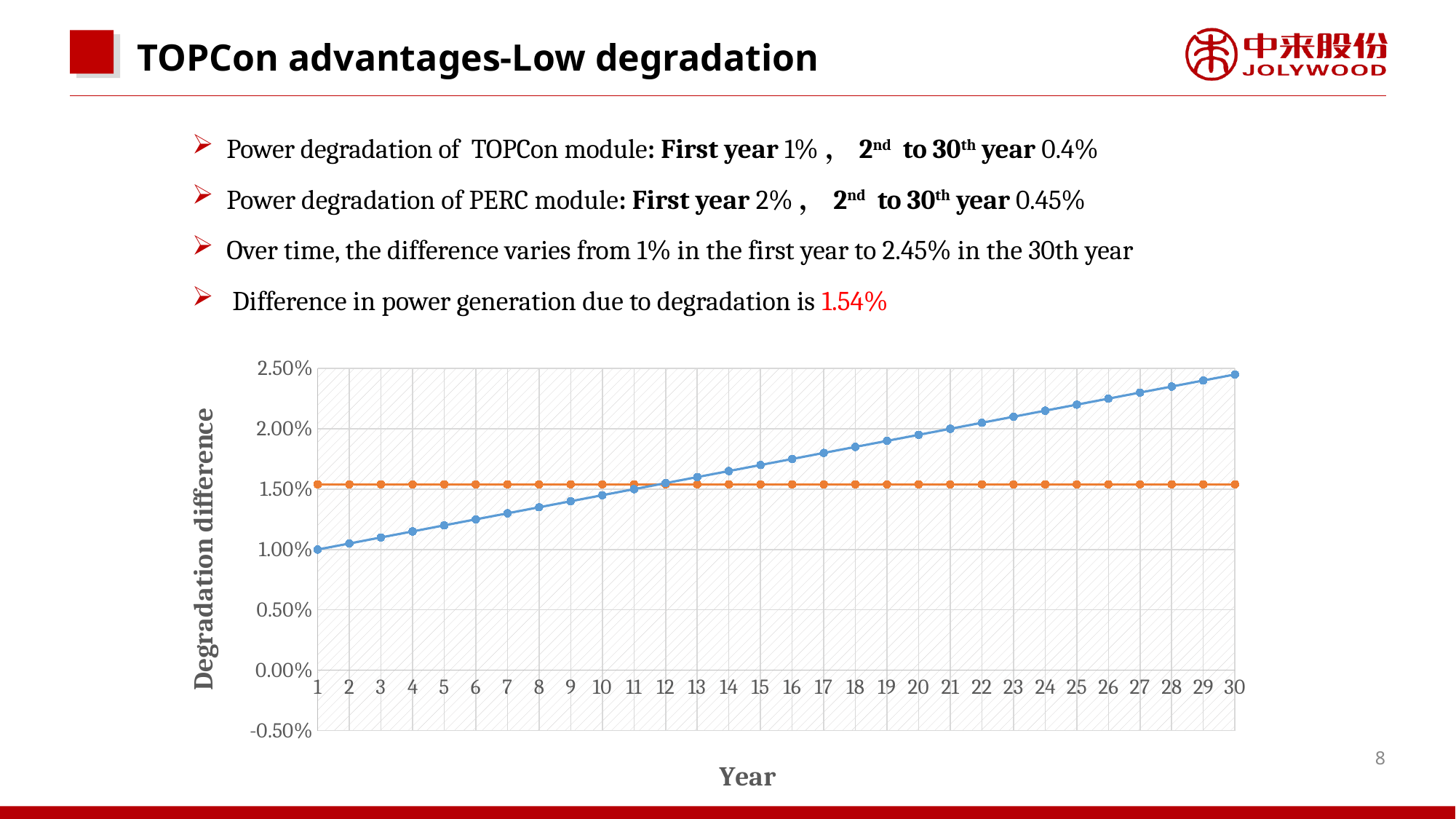
What kind of chart is shown on the slide? line chart What is the title of the chart's horizontal axis? Year Does the blue line rise or fall as the year increases from 1 to 30? rises Does the orange line rise, fall, or stay flat across the years? stays flat What is the title of the chart's vertical axis? Degradation difference How many years (data points) are plotted along the x axis of the chart? 30 Is the value of the blue line at year 5 greater or less than 1.50%? less Is the value of the blue line at year 30 greater or less than 2.00%? greater Is the value of the orange line at year 10 greater or less than 1.00%? greater What is the value of the rising blue line at year 1? 1.00% At year 25, which line has the higher value, the blue line or the orange line? blue line At year 3, which line has the higher value, the blue line or the orange line? orange line